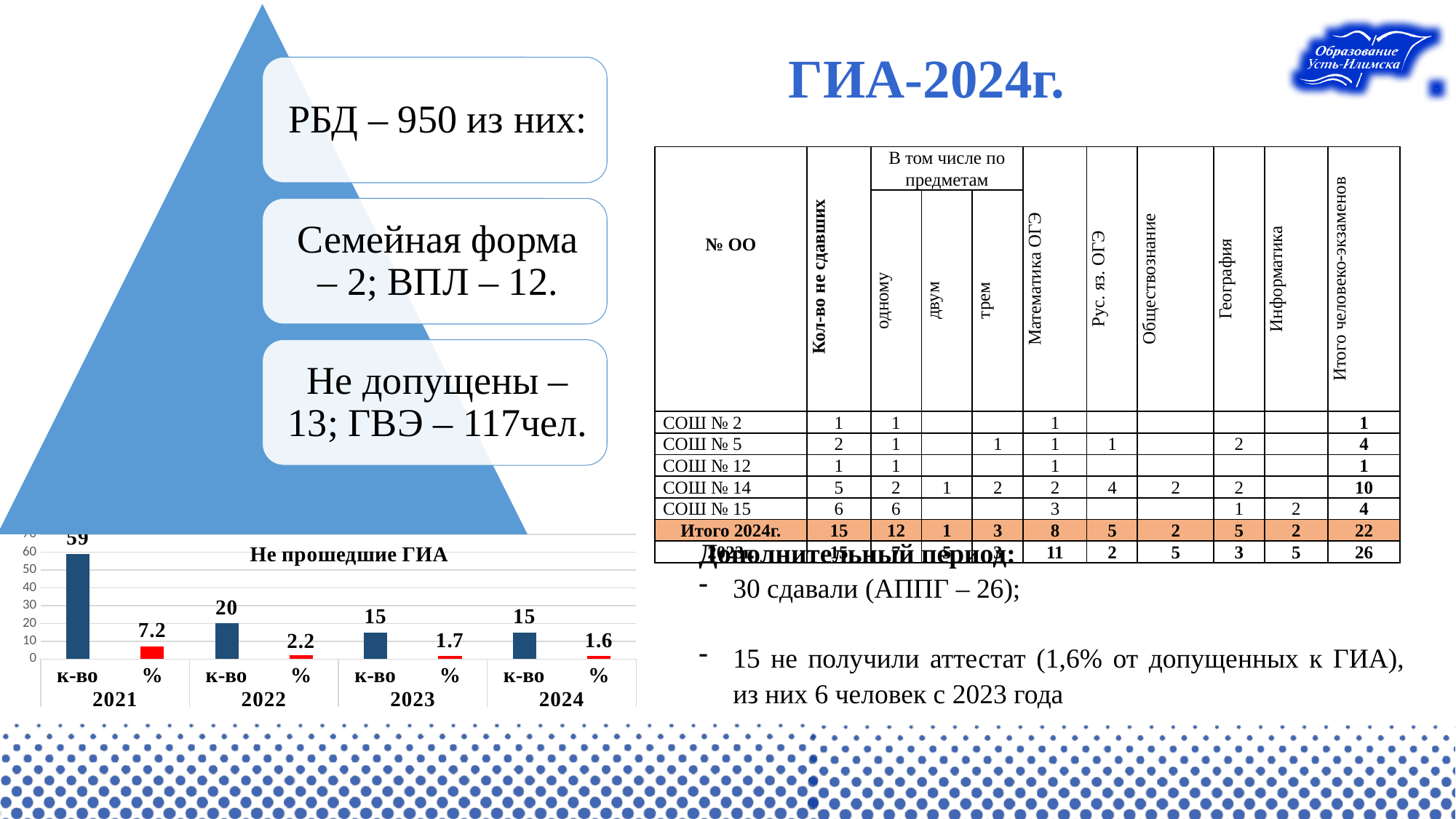
What is the title of the bar chart on the slide? Не прошедшие ГИА In the 'Не прошедшие ГИА' chart, do the к-во values rise or fall from 2021 to 2024? fall In the 'Не прошедшие ГИА' chart, which year has the lowest % value? 2024 How many years are shown on the x axis of the 'Не прошедшие ГИА' chart? 4 In the 'Не прошедшие ГИА' chart, what is the % value for 2024? 1.6 In the 'Не прошедшие ГИА' chart, what is the к-во value for 2021? 59 What type of chart is 'Не прошедшие ГИА'? bar chart In the 'Не прошедшие ГИА' chart, what is the difference between the к-во values for 2021 and 2022? 39 In the 'Не прошедшие ГИА' chart, which is larger: the % value for 2021 or the % value for 2023? 2021 In the 'Не прошедшие ГИА' chart, what is the к-во value for 2023? 15 In the 'Не прошедшие ГИА' chart, which year has the highest к-во value? 2021 In the 'Не прошедшие ГИА' chart, what is the % value for 2022? 2.2